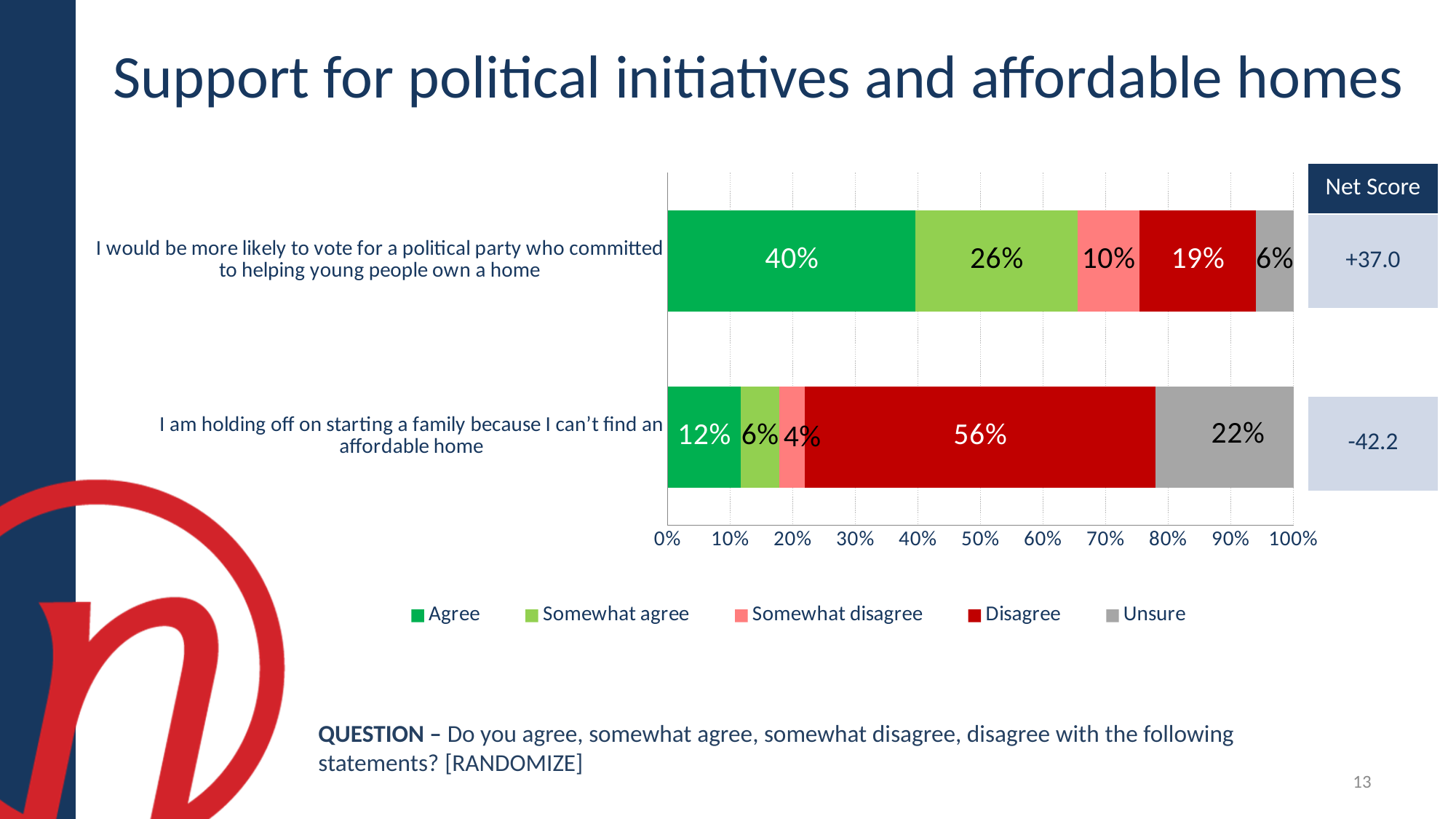
What is the Net Score shown for the statement 'I would be more likely to vote for a political party who committed to helping young people own a home'? +37.0 What is the Somewhat agree value for the statement about voting for a political party who committed to helping young people own a home? 26% What is the difference between the Disagree percentages for the two statements? 37% What is the combined Agree and Somewhat agree percentage for the statement about voting for a political party who committed to helping young people own a home? 66% What is the Net Score shown for the statement 'I am holding off on starting a family because I can't find an affordable home'? -42.2 How many statements are plotted in the chart? 2 What percentage of respondents are unsure about the statement 'I am holding off on starting a family because I can't find an affordable home'? 22% How many series does the legend list? 5 What percentage of respondents disagree with the statement 'I am holding off on starting a family because I can't find an affordable home'? 56% Which statement has the higher Agree percentage? I would be more likely to vote for a political party who committed to helping young people own a home What percentage of respondents agree that they would be more likely to vote for a political party who committed to helping young people own a home? 40% What kind of chart is shown on the slide? Stacked horizontal bar chart